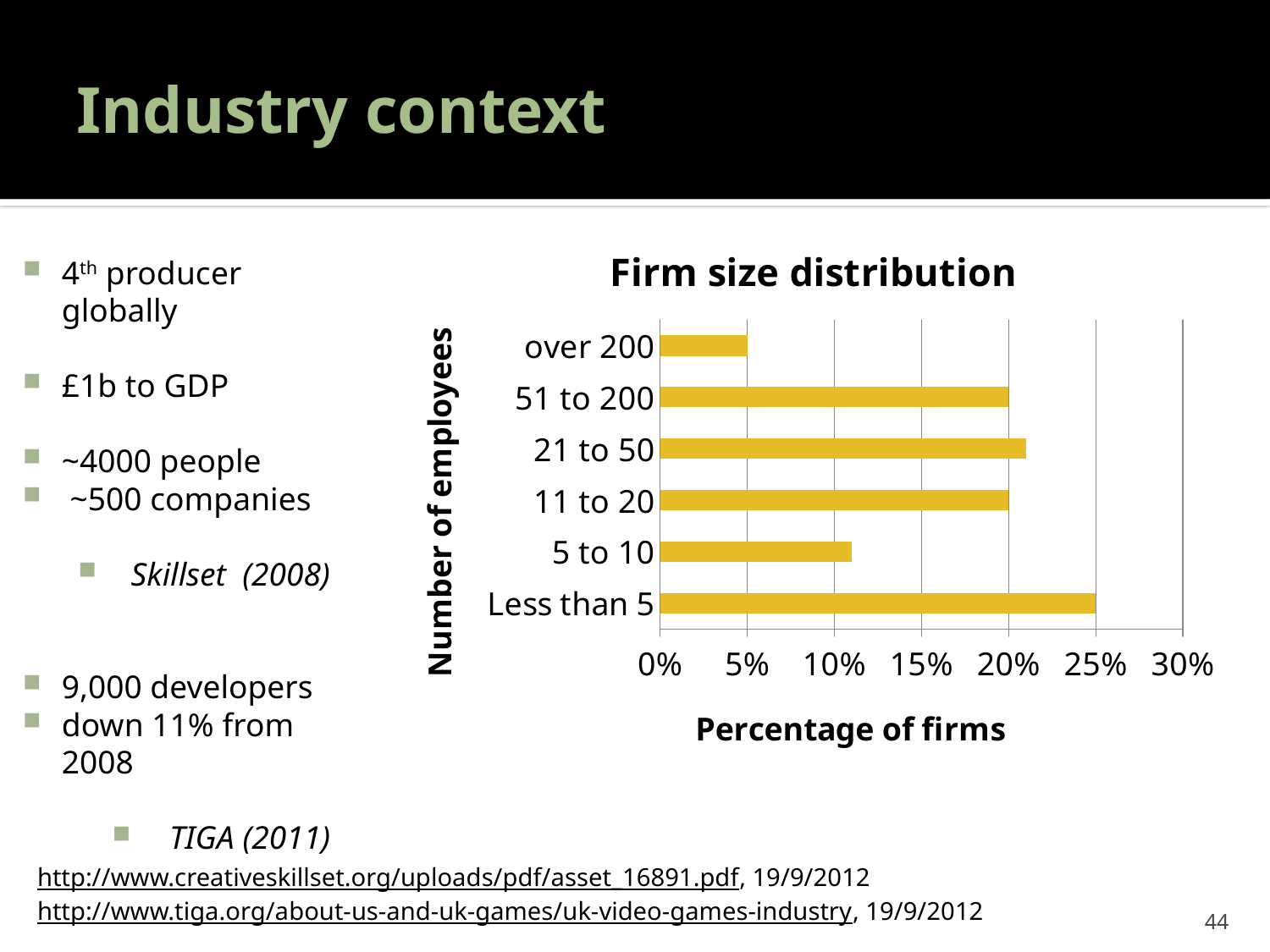
Which has a larger percentage of firms: 5 to 10 employees or 21 to 50 employees? 21 to 50 Which firm size category has the highest percentage of firms? Less than 5 Is the percentage of firms with 21 to 50 employees greater or less than 15%? greater Is the percentage of firms with 5 to 10 employees greater or less than 15%? less Is the percentage of firms with 51 to 200 employees greater or less than 10%? greater What is the percentage of firms with less than 5 employees? 25% What is the label of the horizontal axis of the chart? Percentage of firms What is the title of the chart? Firm size distribution How many firm size categories are shown in the chart? 6 What is the percentage of firms with over 200 employees? 5% Which firm size category has the lowest percentage of firms? over 200 What type of chart is shown on the slide? bar chart